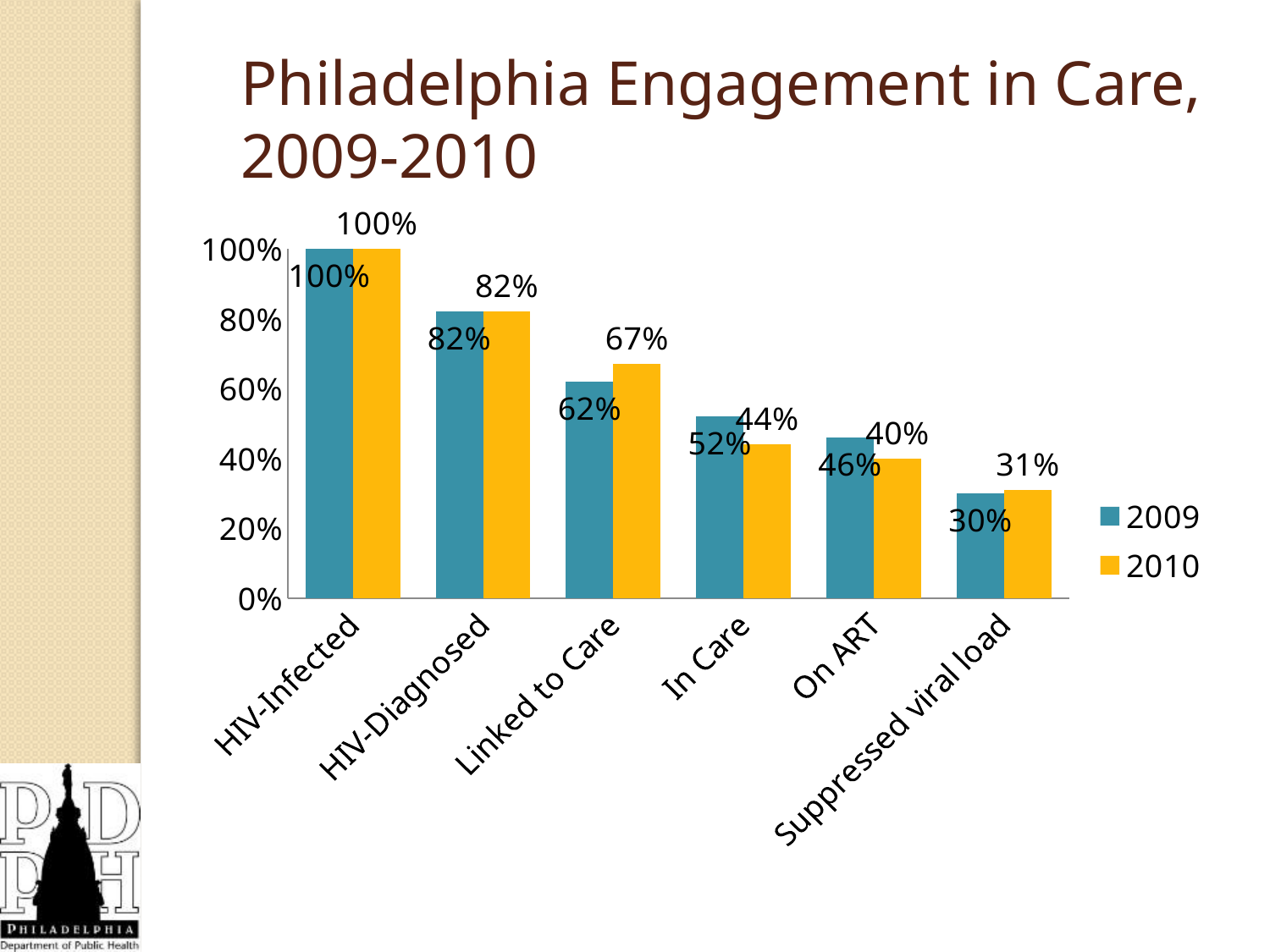
What kind of chart is shown on the slide? Bar chart What is the 2010 value for Linked to Care? 67% What is the 2009 value for Suppressed viral load? 30% How many series does the legend list? 2 How many categories are shown on the x axis? 6 Which is larger for On ART, the 2009 value or the 2010 value? 2009 What is the difference between the 2009 and 2010 values for In Care? 8% What is the 2009 value for In Care? 52% Do the 2010 values rise or fall from HIV-Infected to Suppressed viral load? Fall What is the difference between the 2009 and 2010 values for Linked to Care? 5% Which category has the lowest 2010 value? Suppressed viral load What is the 2010 value for On ART? 40%